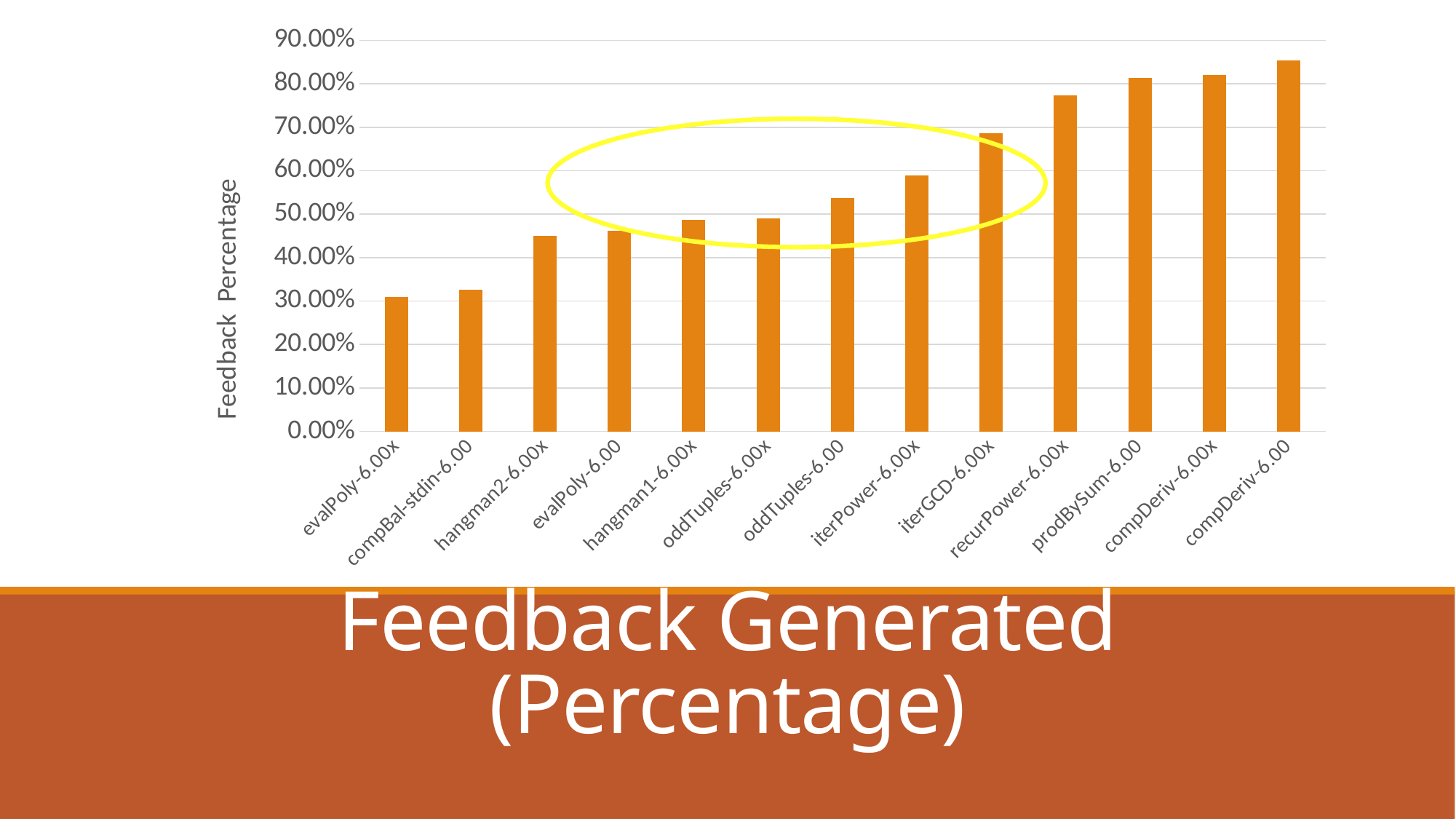
Is the value for compDeriv-6.00 greater or less than 80.00%? greater Which has a higher feedback percentage, hangman2-6.00x or oddTuples-6.00? oddTuples-6.00 Which category has the lowest feedback percentage? evalPoly-6.00x Is the value for evalPoly-6.00x greater or less than 40.00%? less How many categories are plotted on the x axis of the chart? 13 Which category has the highest feedback percentage? compDeriv-6.00 Is the value for iterGCD-6.00x greater or less than 60.00%? greater What kind of chart is shown on the slide? bar chart What is the label on the vertical axis of the chart? Feedback Percentage Which has a higher feedback percentage, recurPower-6.00x or iterGCD-6.00x? recurPower-6.00x Do the bar values generally rise or fall from left to right along the x axis? rise